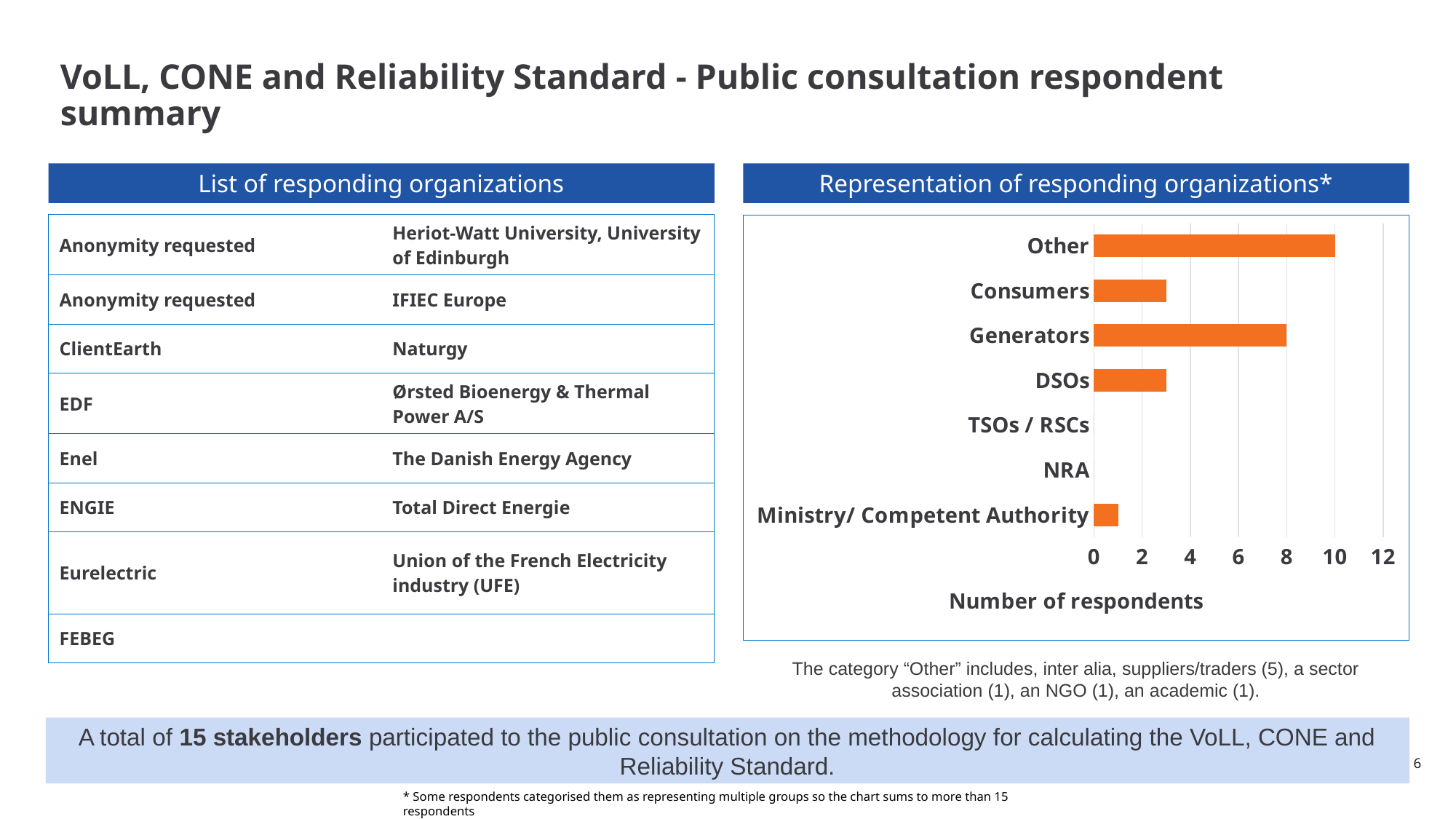
What type of chart is shown on the slide? bar chart Is the value for Consumers greater or less than 4? less Is the value for Ministry/ Competent Authority greater or less than 2? less Which category has the highest number of respondents? Other What is the number of respondents for Generators? 8 What is the title of the chart's horizontal axis? Number of respondents How many categories are shown on the chart? 7 What is the number of respondents for Other? 10 Which has more respondents, Generators or Consumers? Generators What is the difference in number of respondents between Other and Generators? 2 Which has more respondents, Other or Generators? Other Is the value for DSOs greater or less than 2? greater